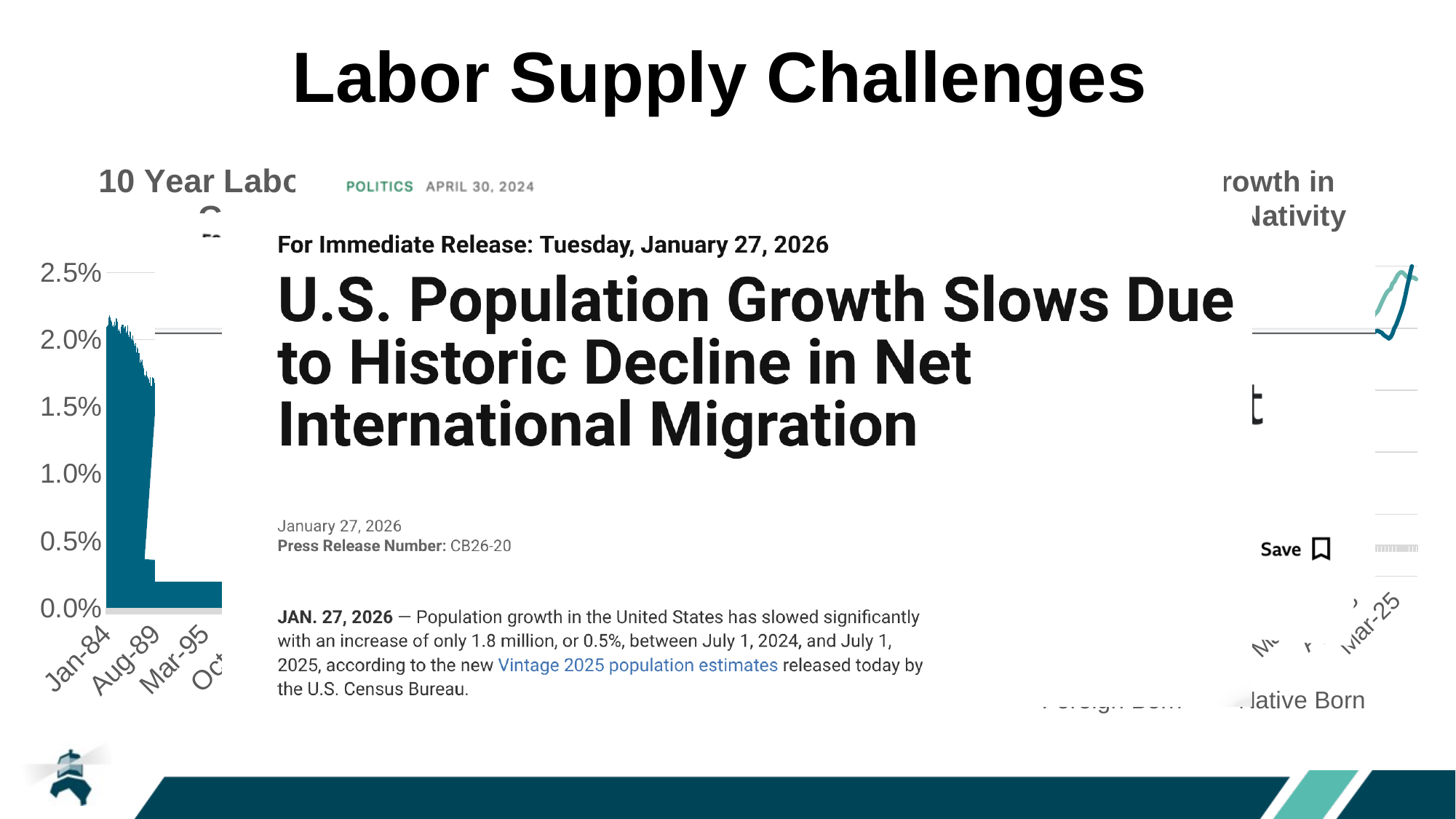
On the left chart, is the value at Aug-89 greater or less than 1.0%? less On the left chart, which x-axis label comes immediately after Jan-84? Aug-89 On the left chart, is the value at Jan-84 greater or less than 1.5%? greater On the left chart, what is the first label on the x axis? Jan-84 On the left chart, do the values rise or fall between Jan-84 and Aug-89? fall On the left chart, what is the highest value shown on the y axis? 2.5% On the left chart, what is the lowest value shown on the y axis? 0.0%